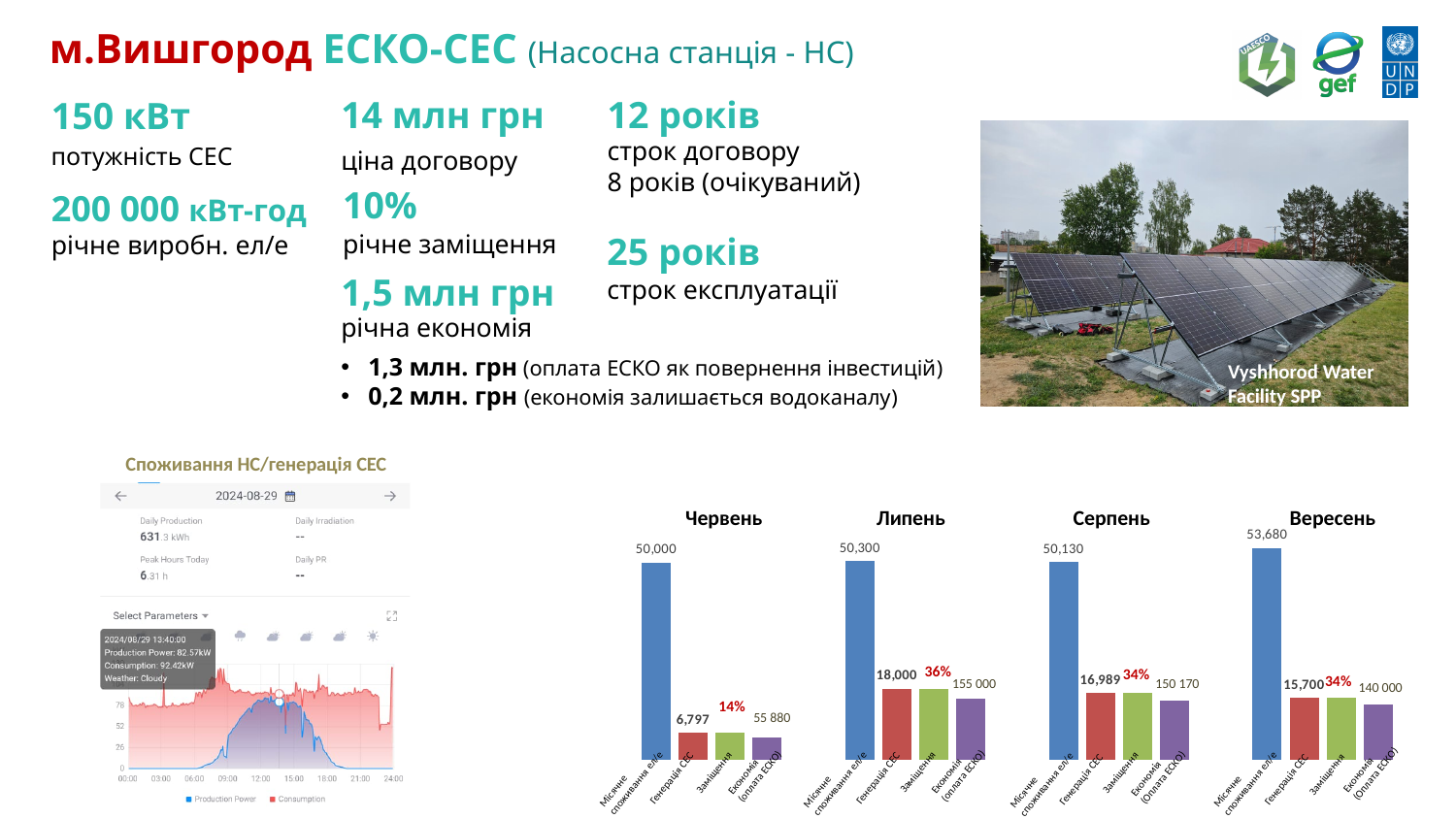
In the chart titled Червень, what is the value for Місячне споживання ел/е? 50,000 Across the four monthly charts (Червень, Липень, Серпень, Вересень), which month has the highest value for Місячне споживання ел/е? Вересень In the chart titled Споживання НС/генерація СЕС on the left, how many series does the legend list? 2 What is the difference between Місячне споживання ел/е in the Вересень chart and in the Червень chart? 3,680 Which is larger: Генерація СЕС in the Липень chart or in the Серпень chart? Липень In the chart titled Липень, what is the value for Генерація СЕС? 18,000 How many bars are plotted in the chart titled Серпень? 4 In the chart titled Вересень, what is the value for Економія (оплата ЕСКО)? 140 000 In the chart titled Червень, what percentage is shown for Заміщення? 14% In the chart titled Серпень, what percentage is shown for Заміщення? 34% Across the four monthly charts, which month has the lowest value for Генерація СЕС? Червень What kind of chart is the chart titled Липень? bar chart